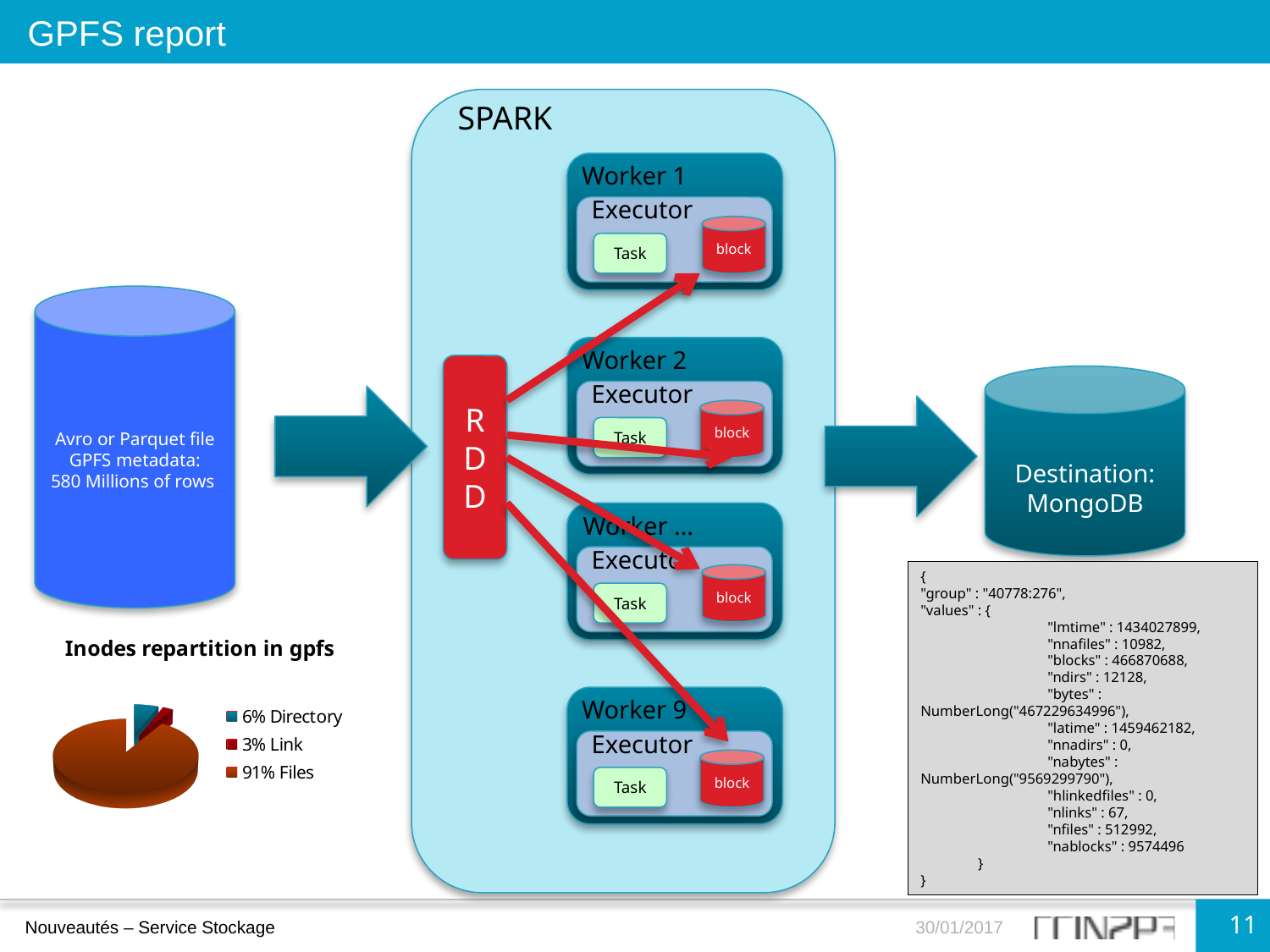
In the pie chart, what is the difference between the Directory share and the Link share? 3% In the pie chart, what is the difference between the Files share and the Directory share? 85% What kind of chart is shown under the heading "Inodes repartition in gpfs"? pie chart What is the title of the pie chart on the slide? Inodes repartition in gpfs Which category has the largest slice in the pie chart? Files In the pie chart, which is larger: the Directory share or the Link share? Directory Which category has the smallest slice in the pie chart? Link How many entries does the legend of the pie chart list? 3 In the pie chart, what share of inodes are Files? 91% In the pie chart, what share of inodes are Directory? 6% In the pie chart, what share of inodes are Link? 3% How many categories does the pie chart show? 3